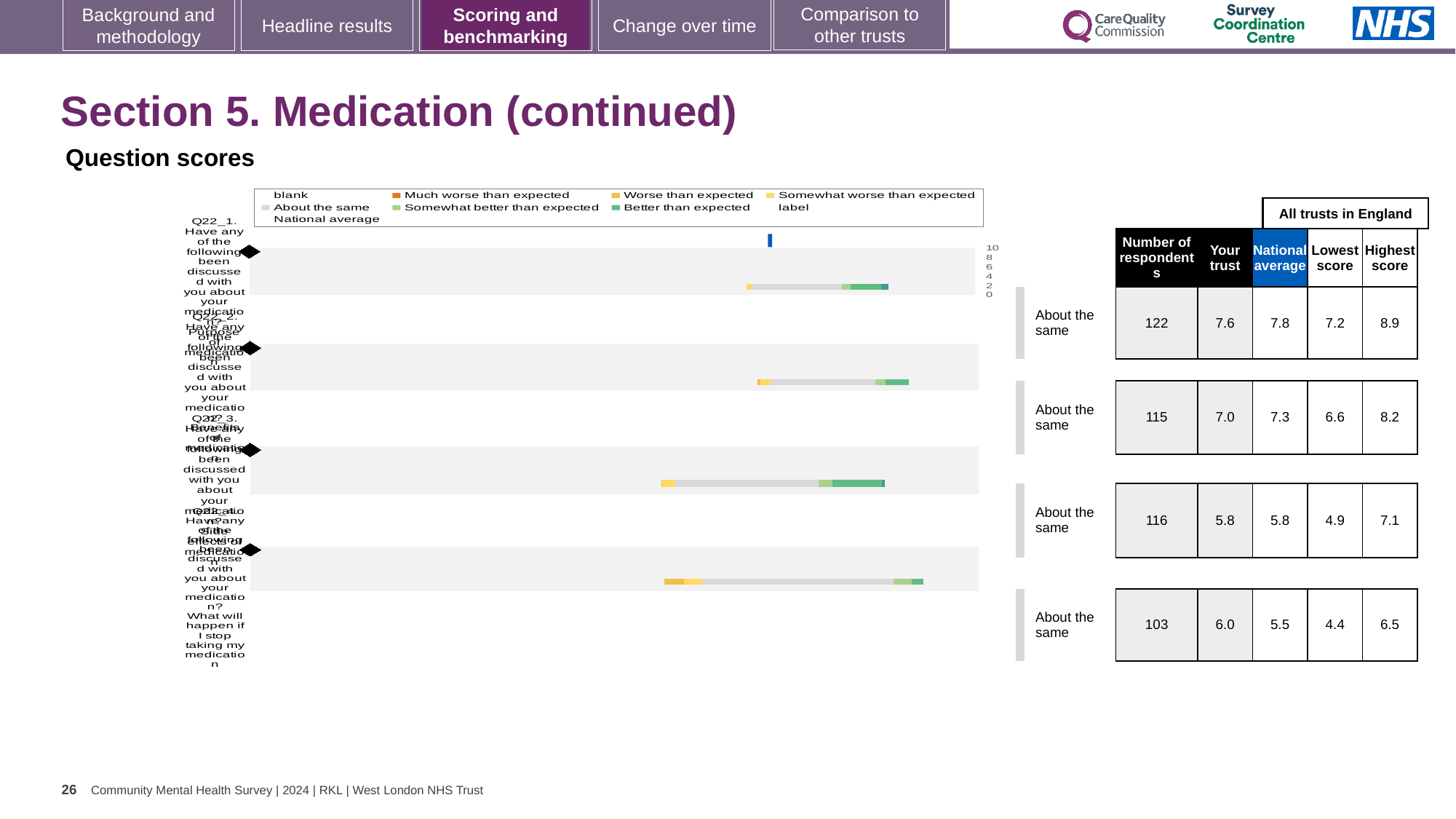
How many respondents are there for the third row of the table? 116 What is the national average for the row with 115 respondents? 7.3 What benchmark category is shown for each of the four question rows? About the same What heading appears above the 'National average', 'Lowest score' and 'Highest score' columns? All trusts in England What is the 'Your trust' score for the row with 122 respondents? 7.6 What kind of chart is shown under 'Question scores'? bar chart Which row has the highest 'Your trust' score? the first row (122 respondents), 7.6 What is the difference between 'Your trust' and the national average for the row with 103 respondents? 0.5 What is the difference between the highest score and the lowest score for the first row (122 respondents)? 1.7 How many question rows are plotted in the chart? 4 For the last row (103 respondents), is the 'Your trust' score higher or lower than the national average? higher Which row has the lowest 'Your trust' score? the third row (116 respondents), 5.8